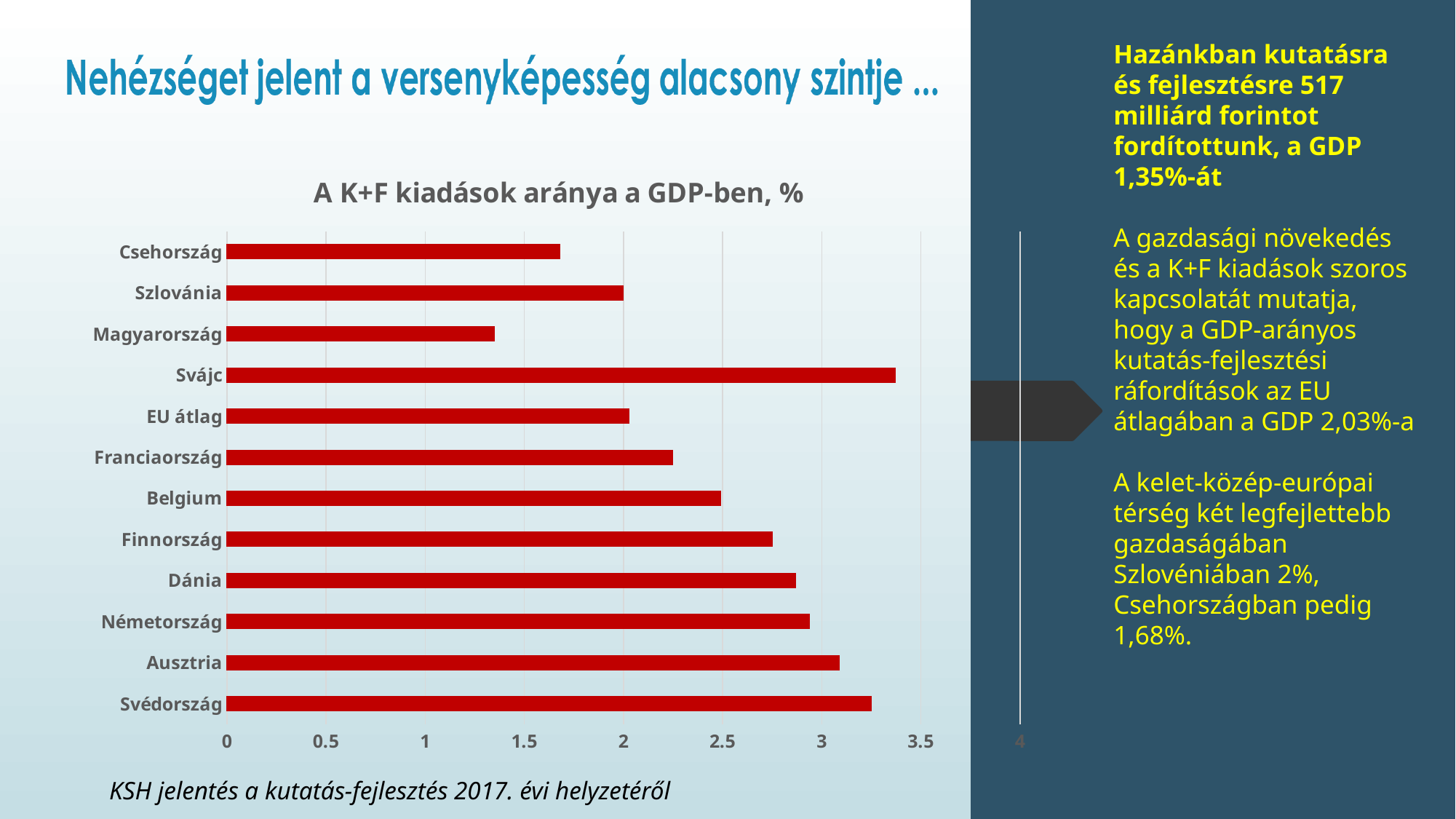
Is the value for Németország greater or less than 3? less Is the value for Svájc greater or less than 3? greater What is the title of the chart? A K+F kiadások aránya a GDP-ben, % What colour are the bars in the chart? red Which has the larger value, Ausztria or Dánia? Ausztria Is the value for Magyarország greater or less than 1.5? less How many countries/categories are plotted in the chart? 12 What kind of chart is shown on the slide? bar chart Which category has the highest value in the chart? Svájc Which category has the lowest value in the chart? Magyarország